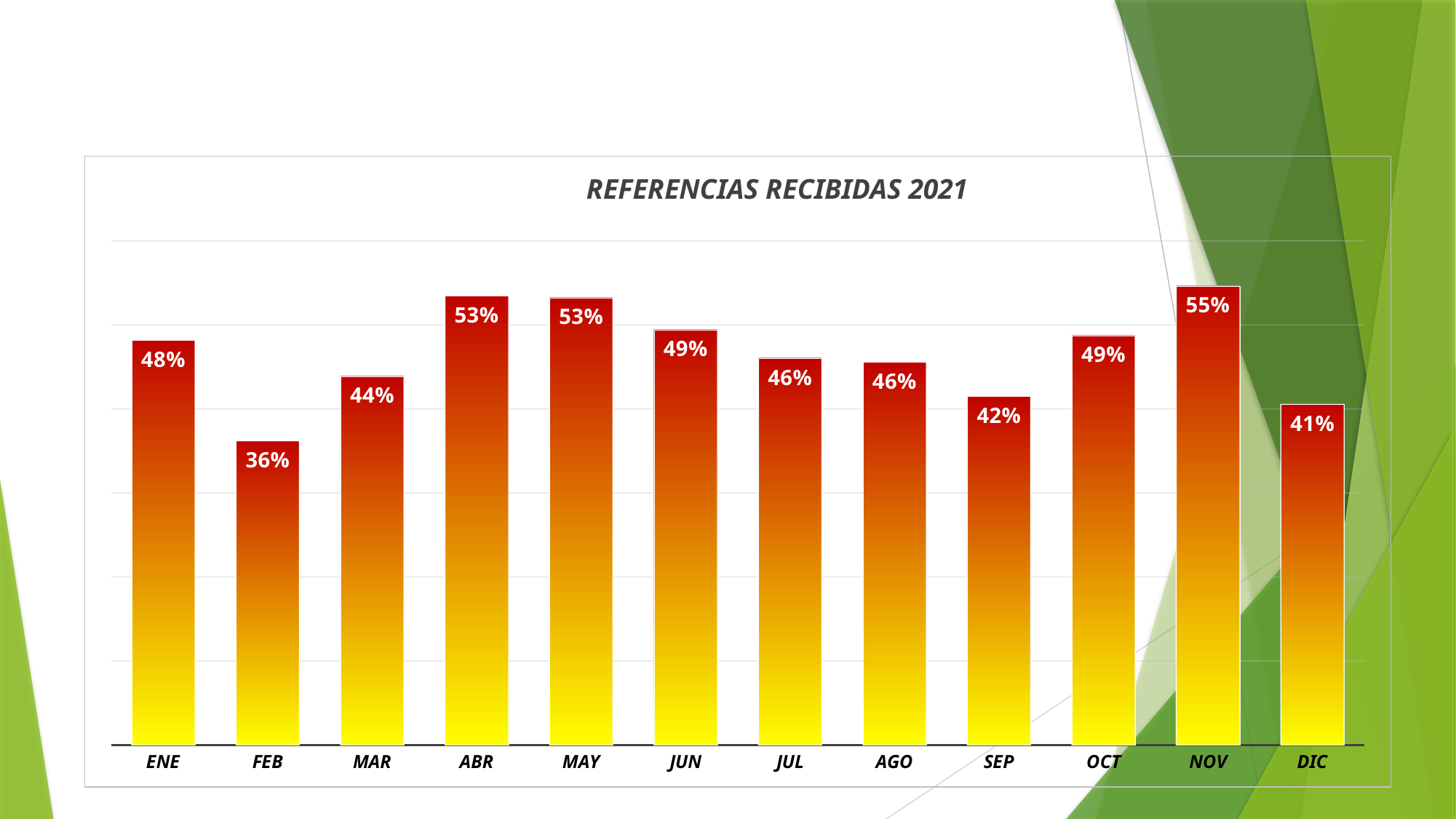
Do the values rise or fall from SEP to NOV? rise Which month has the lowest value? FEB What is the difference between the values for NOV and FEB? 19% What is the difference between the values for ABR and MAR? 9% What is the value for DIC? 41% What is the title of the chart? REFERENCIAS RECIBIDAS 2021 How many months are shown on the x axis? 12 Which month has the highest value? NOV Which is larger, the value for JUN or the value for AGO? JUN What kind of chart is this? bar chart What is the value for ENE? 48% What is the value for SEP? 42%